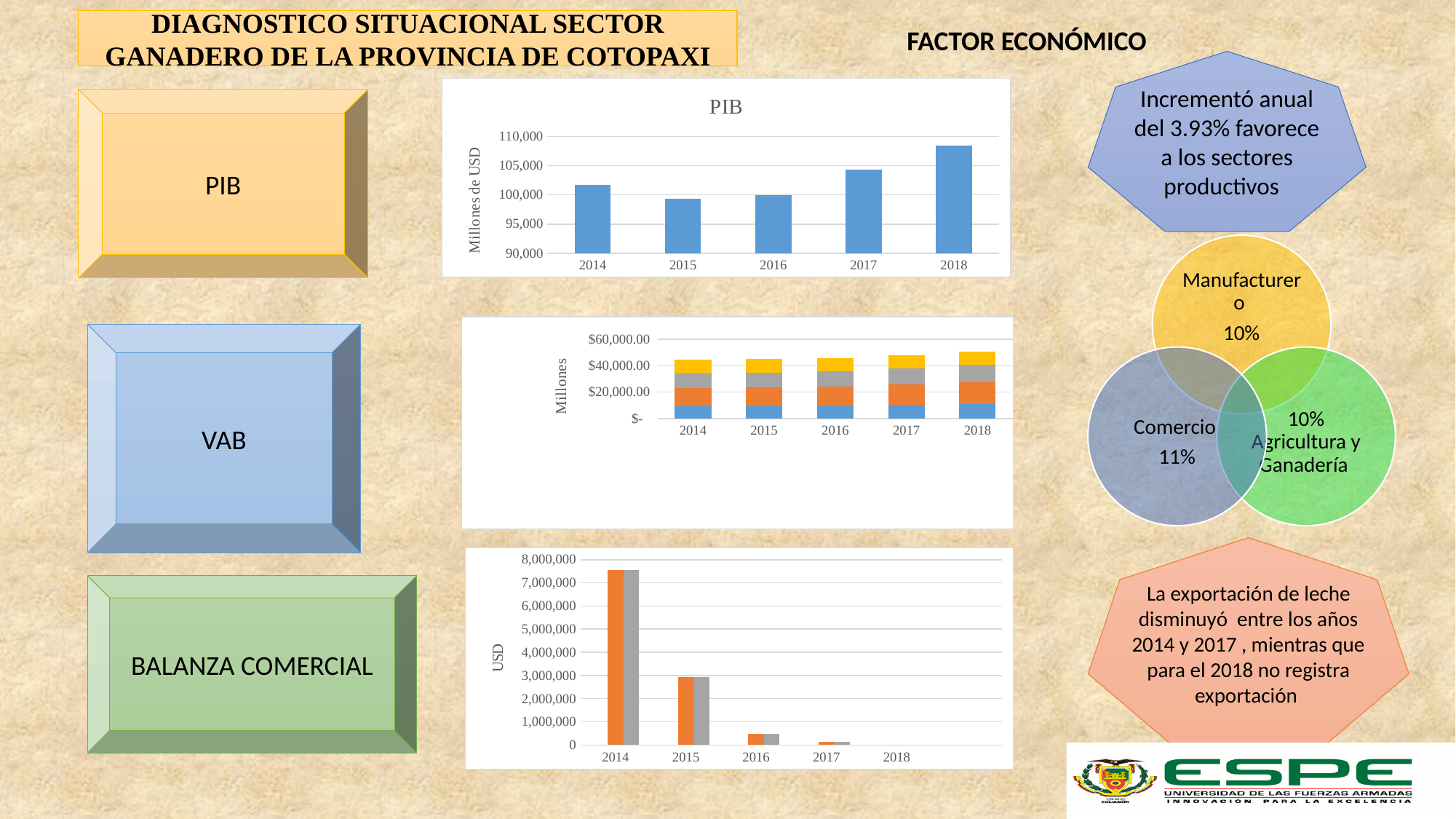
In the bottom chart next to the BALANZA COMERCIAL box, do the values rise or fall from 2014 to 2018? fall What is the y-axis label of the PIB chart at the top? Millones de USD In the PIB chart at the top, which year has the highest value? 2018 In the bottom chart next to the BALANZA COMERCIAL box, which year has the highest value? 2014 In the PIB chart at the top, which year has the lowest value? 2015 How many years are shown on the x axis of the PIB chart at the top? 5 What kind of chart is the middle chart next to the VAB box? stacked bar chart In the middle stacked bar chart next to the VAB box, is the total for 2018 greater or less than $60,000.00? less In the PIB chart at the top, is the value for 2015 greater or less than 100,000? less In the PIB chart at the top, is the value for 2018 greater or less than 105,000? greater In the PIB chart at the top, which is larger, the value for 2017 or the value for 2016? 2017